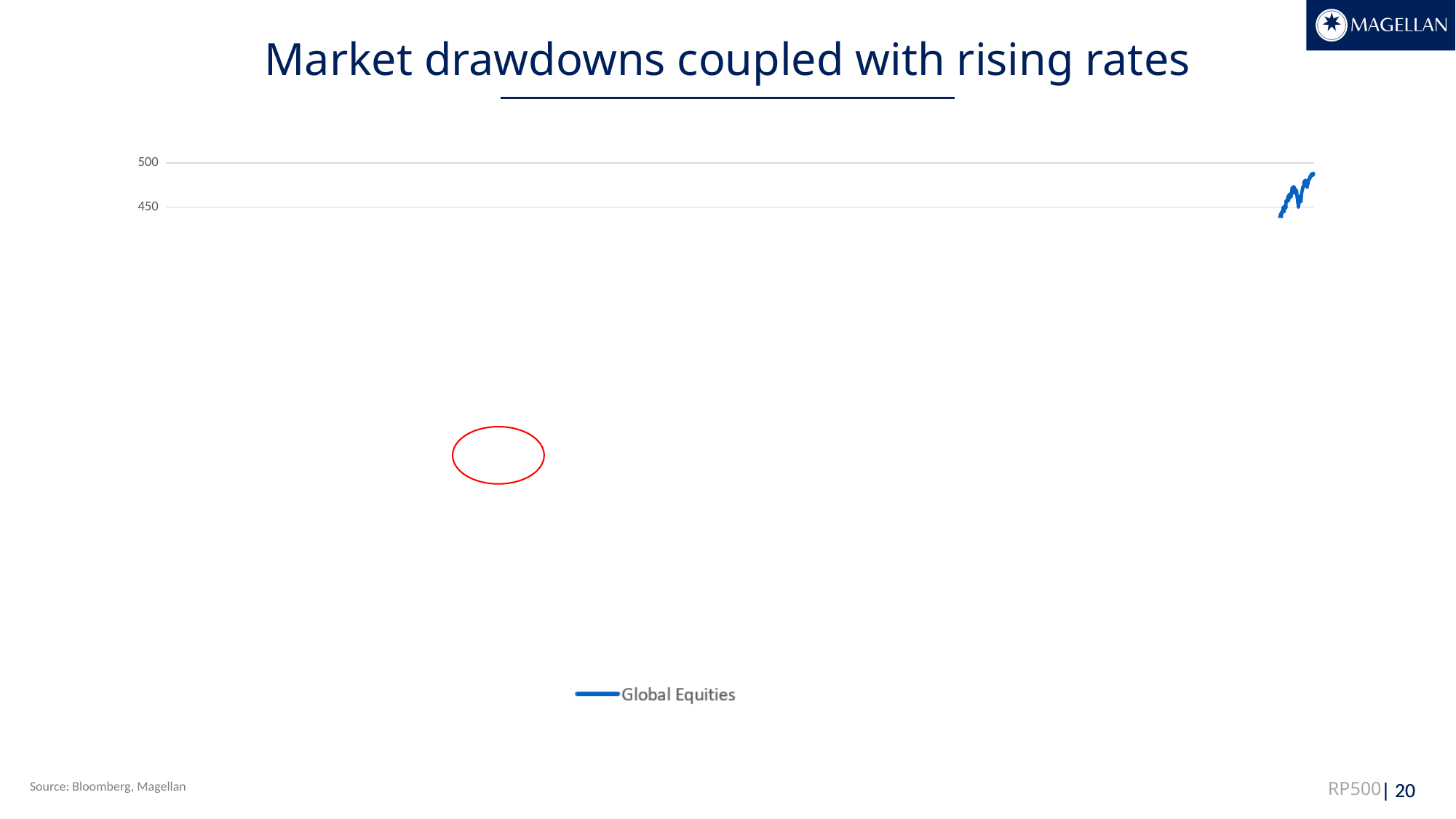
What is the name of the series shown in the chart legend? Global Equities What kind of chart is shown on the slide? line chart How many series does the chart legend list? 1 Does the visible portion of the Global Equities line rise or fall toward the right end of the chart? rises Is the value of the Global Equities line at its right-hand end greater or less than 450? greater What is the title of the slide containing the chart? Market drawdowns coupled with rising rates